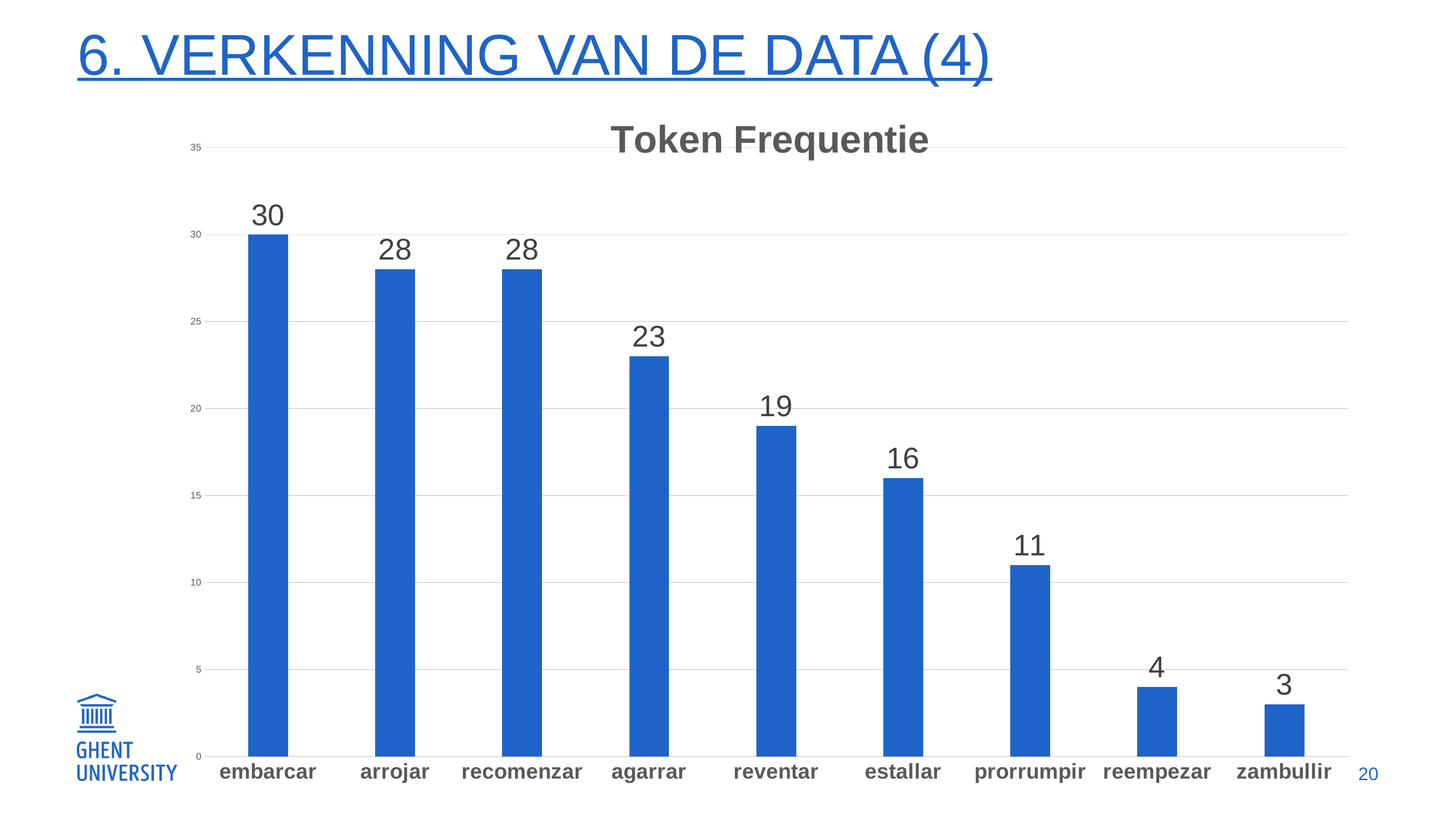
How many verbs are shown in the chart? 9 What is the token frequency for embarcar? 30 Do the token frequencies rise or fall from left to right along the x axis? fall Which verb has the lowest token frequency? zambullir What is the title of the chart? Token Frequentie What is the difference in token frequency between estallar and reempezar? 12 What kind of chart is shown on the slide? bar chart What is the difference in token frequency between embarcar and reventar? 11 Which has a higher token frequency, agarrar or estallar? agarrar What is the token frequency for prorrumpir? 11 What is the token frequency for agarrar? 23 Which verb has the highest token frequency? embarcar